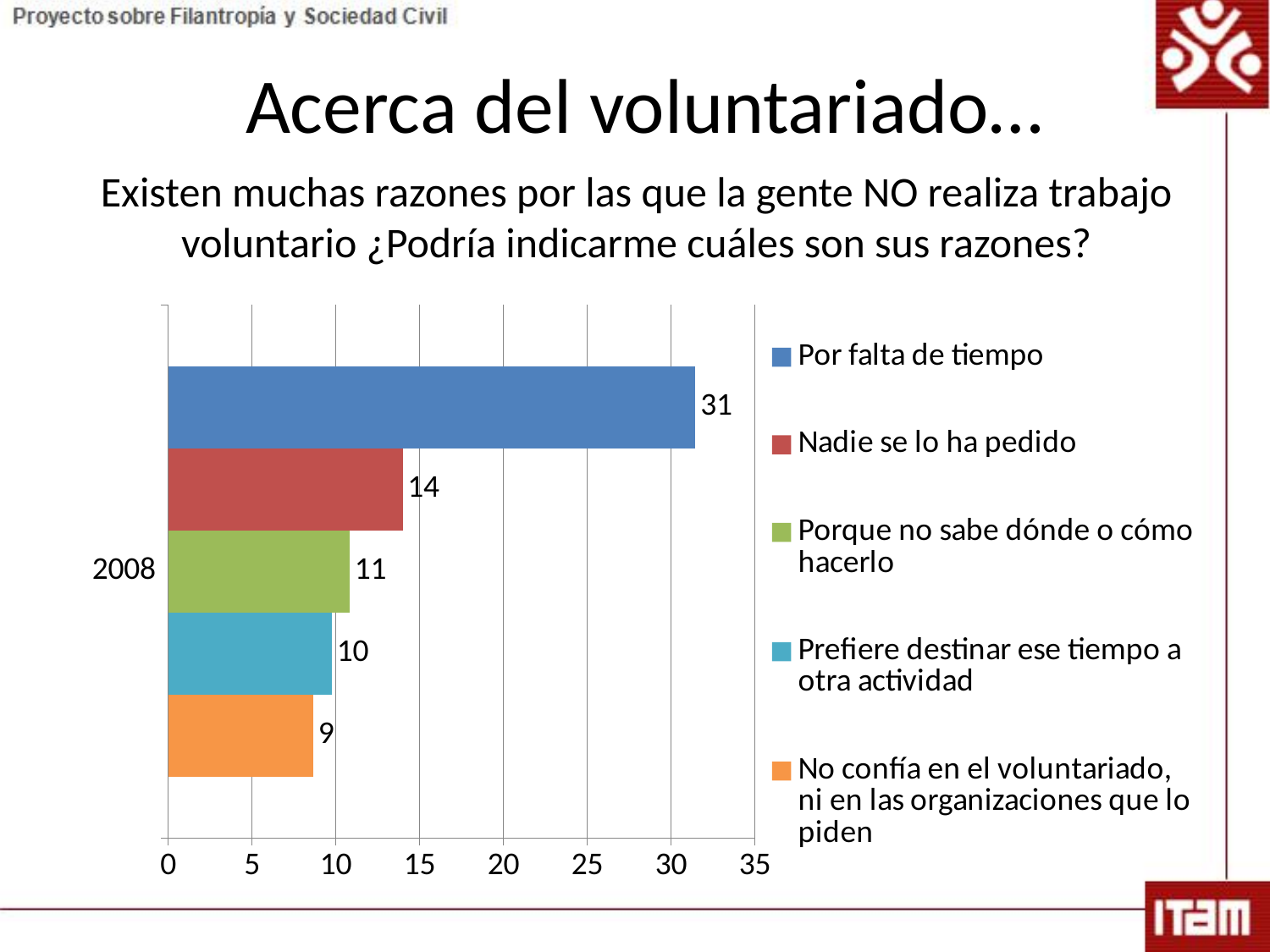
What is the value for "Nadie se lo ha pedido"? 14 Which is larger, the value for "Nadie se lo ha pedido" or the value for "Porque no sabe dónde o cómo hacerlo"? Nadie se lo ha pedido Which reason has the lowest value? No confía en el voluntariado, ni en las organizaciones que lo piden What is the difference between the values for "Por falta de tiempo" and "Nadie se lo ha pedido"? 17 How many series does the legend list? 5 What is the value for "Prefiere destinar ese tiempo a otra actividad"? 10 What kind of chart is shown on the slide? Bar chart What is the value for "Por falta de tiempo"? 31 What is the value for "No confía en el voluntariado, ni en las organizaciones que lo piden"? 9 Which reason has the highest value? Por falta de tiempo What year label appears on the vertical axis of the chart? 2008 What is the value for "Porque no sabe dónde o cómo hacerlo"? 11